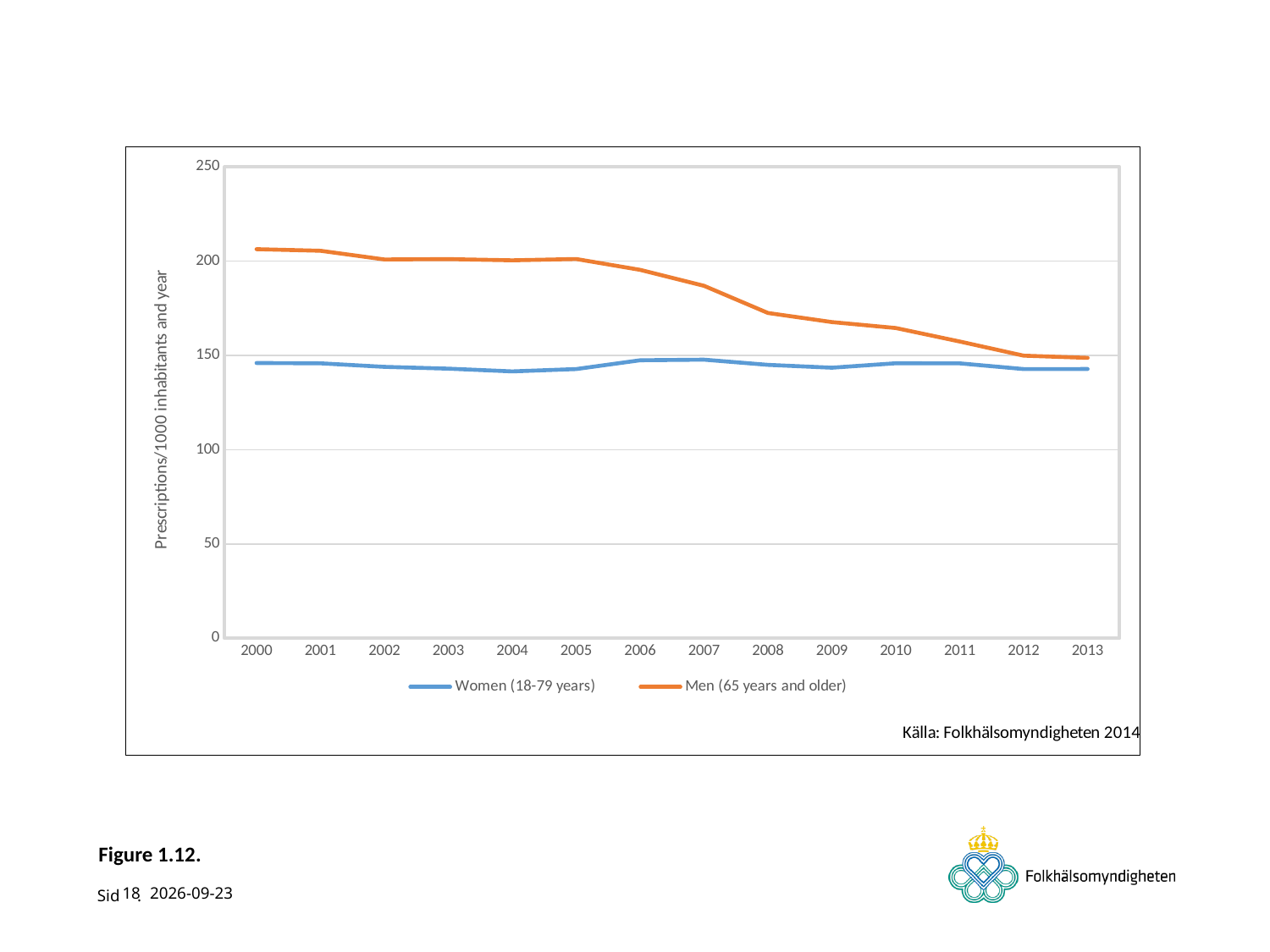
Which series has the higher value in 2000, Women (18-79 years) or Men (65 years and older)? Men (65 years and older) How many series does the legend list? 2 What kind of chart is shown on the slide? line chart Does the value for Men (65 years and older) rise or fall from 2000 to 2013? fall Which colour is used for the Men (65 years and older) line? orange Which series has the higher value in 2013, Women (18-79 years) or Men (65 years and older)? Men (65 years and older) Is the value for Women (18-79 years) in 2004 greater or less than 150? less Is the value for Men (65 years and older) in 2008 greater or less than 150? greater How many years are plotted along the x axis? 14 Is the value for Men (65 years and older) in 2010 greater or less than 200? less What is the label on the y axis? Prescriptions/1000 inhabitants and year